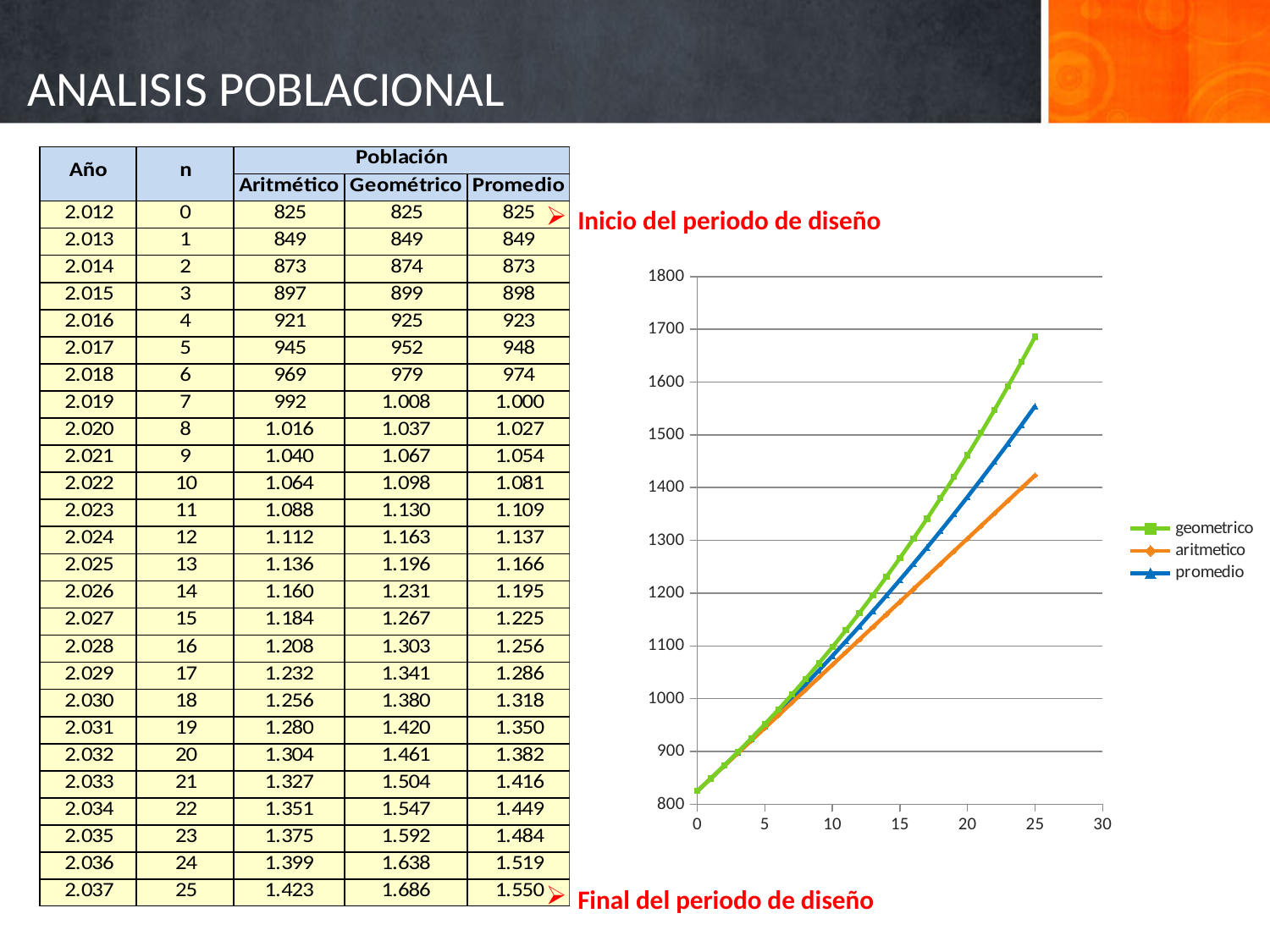
At x = 25, which is larger: the geometrico series or the aritmetico series? geometrico Is the value of the aritmetico series at x = 25 greater or less than 1500? less What is the highest tick value shown on the chart's vertical axis? 1800 Which series in the chart is drawn in orange? aritmetico Which series in the chart has the lowest value at x = 25? aritmetico Is the value of the promedio series at x = 25 greater or less than 1500? greater Which series in the chart reaches the highest value at x = 25? geometrico How many series does the chart legend list? 3 What kind of chart is shown on the slide? line chart Is the value of the geometrico series at x = 25 greater or less than 1600? greater Do the values of the geometrico series rise or fall as x increases? rise